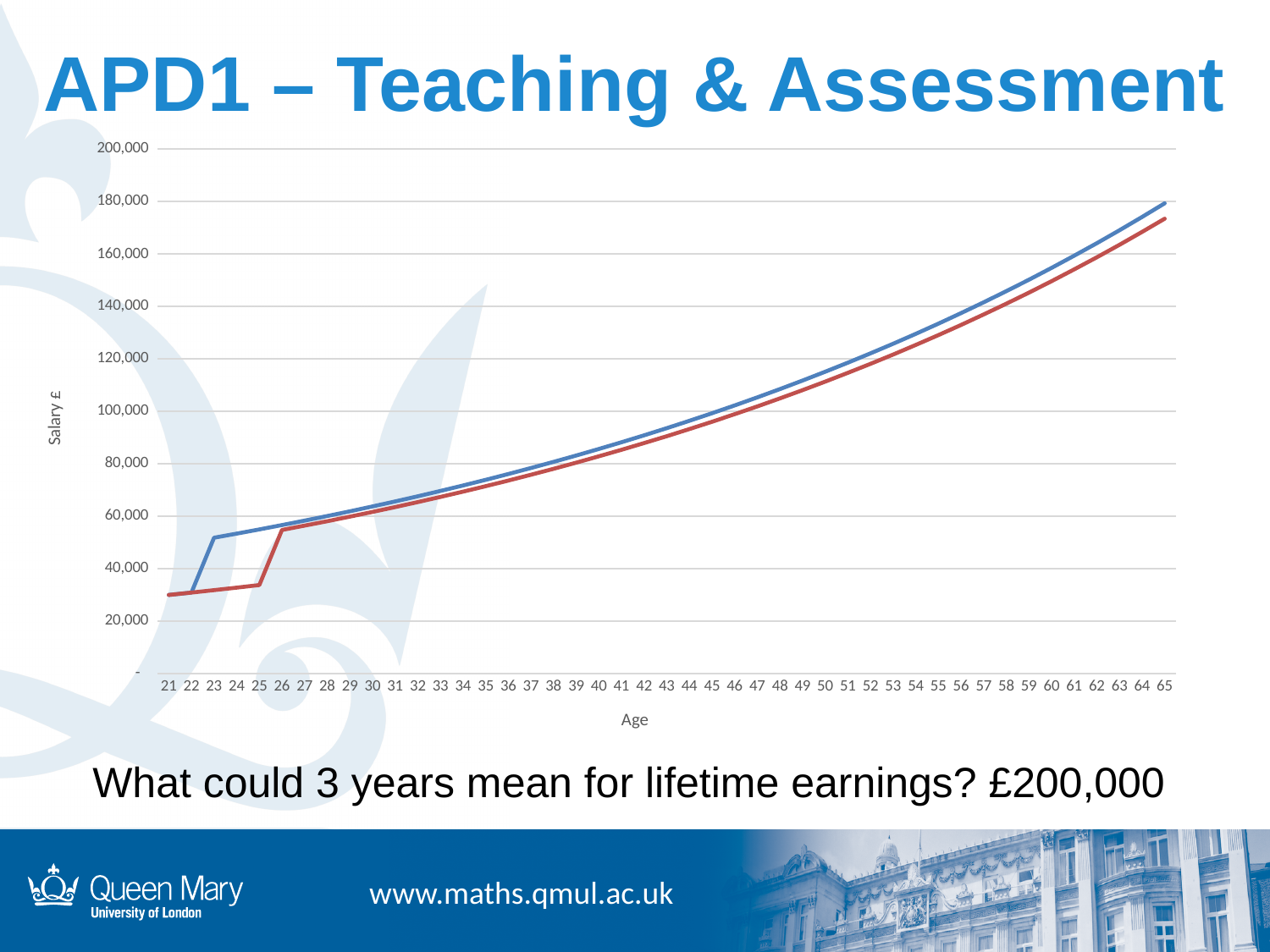
At age 65, which line is higher, the blue line or the red line? the blue line How many lines are plotted on the chart? 2 Is the value of the red line at age 65 greater or less than 180,000? less Is the value of the red line at age 35 greater or less than 80,000? less Is the value of the blue line at age 50 greater or less than 100,000? greater What is the highest age shown on the horizontal axis? 65 How many age values are shown on the horizontal axis? 45 Do the salary values rise or fall as age increases from 21 to 65? rise What is the label of the vertical axis? Salary £ What is the label of the horizontal axis? Age What kind of chart is shown on the slide? line chart What is the lowest age shown on the horizontal axis? 21